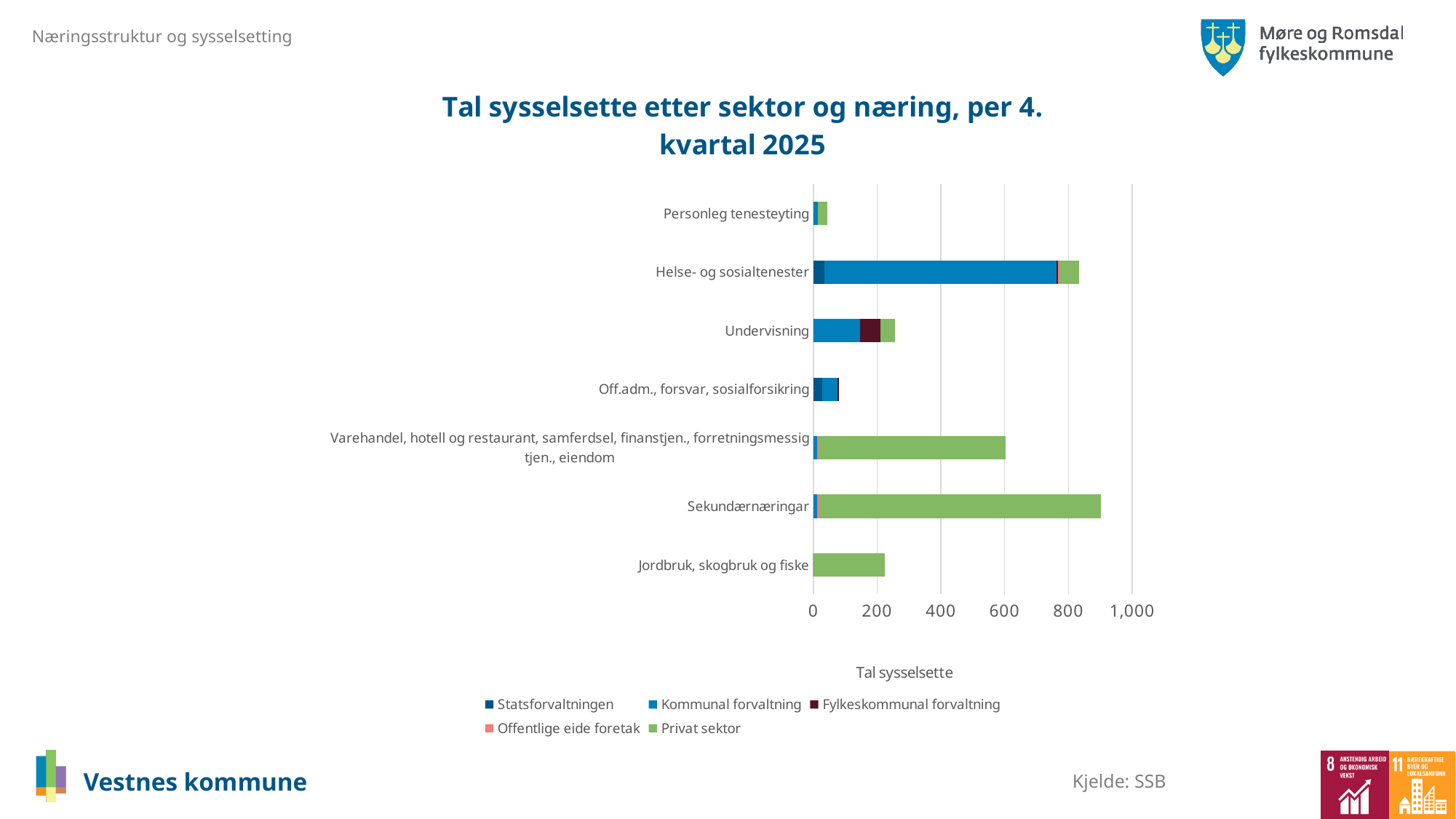
What kind of chart is shown on the slide? bar chart Is the total value for Sekundærnæringar greater or less than 800? greater Which category has the longest total bar? Sekundærnæringar Is the total value for Helse- og sosialtenester greater or less than 600? greater What is the title of the chart? Tal sysselsette etter sektor og næring, per 4. kvartal 2025 How many series does the legend list? 5 Which category has the shortest total bar? Personleg tenesteyting Is the total value for Off.adm., forsvar, sosialforsikring greater or less than 200? less Which has the larger total bar, Sekundærnæringar or Helse- og sosialtenester? Sekundærnæringar How many categories (næringar) are shown on the y axis of the chart? 7 Which has the larger total bar, Undervisning or Varehandel, hotell og restaurant, samferdsel, finanstjen., forretningsmessig tjen., eiendom? Varehandel, hotell og restaurant, samferdsel, finanstjen., forretningsmessig tjen., eiendom